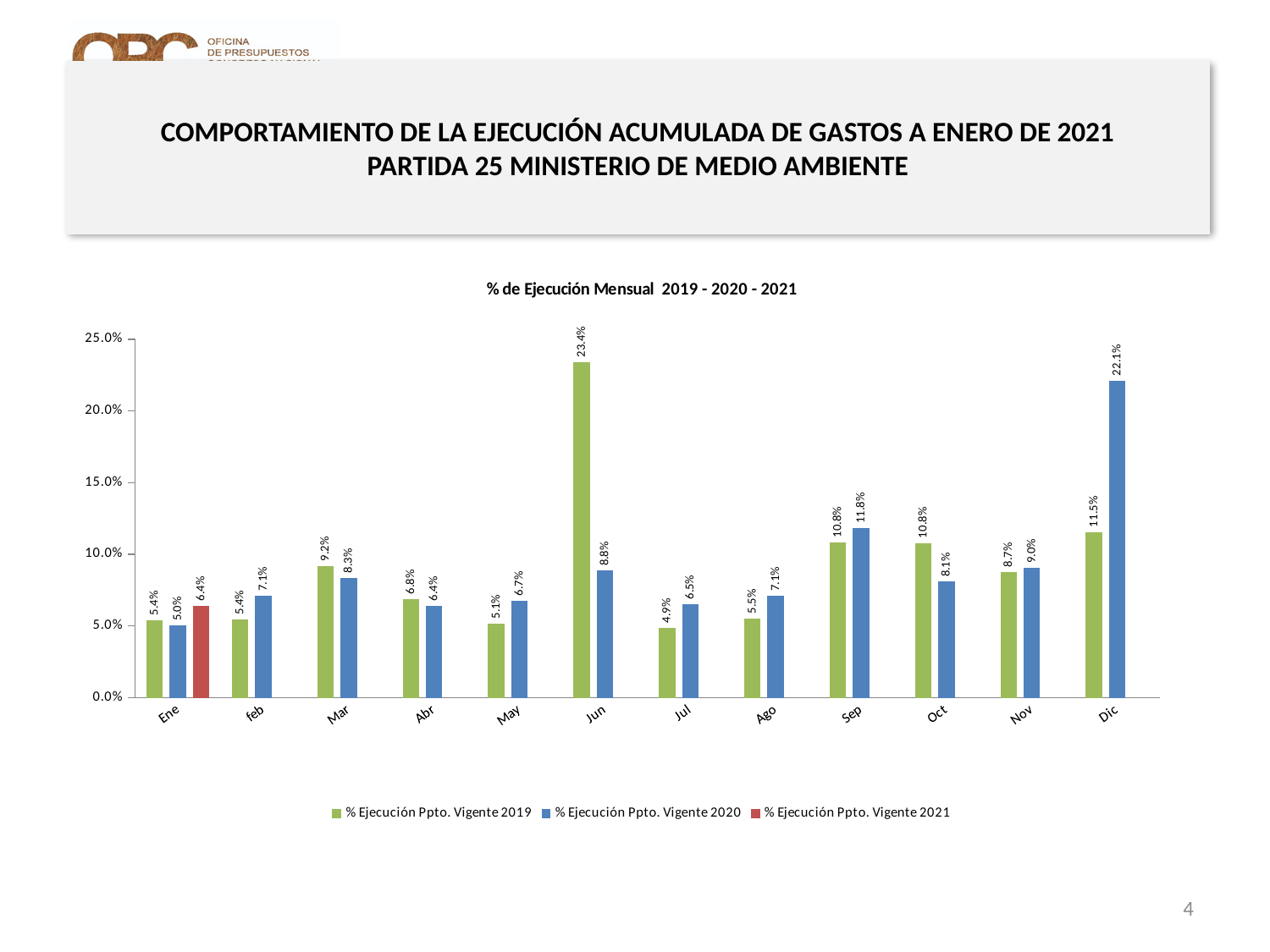
Which month has the lowest value in the % Ejecución Ppto. Vigente 2020 series? Ene What is the value for Ene in the % Ejecución Ppto. Vigente 2021 series? 6.4% Is the value for Jun in the 2019 series greater or less than 20.0%? greater What is the title of the chart? % de Ejecución Mensual 2019 - 2020 - 2021 What kind of chart is shown on the slide? Bar chart What is the value for Dic in the % Ejecución Ppto. Vigente 2020 series? 22.1% Which month has the highest value in the % Ejecución Ppto. Vigente 2019 series? Jun How many series does the legend list? 3 What is the difference between the 2020 and 2019 values for Dic? 10.6% What is the value for Jun in the % Ejecución Ppto. Vigente 2019 series? 23.4% Which is larger for Sep: the 2019 value or the 2020 value? 2020 value (11.8%) How many months are shown on the x axis? 12